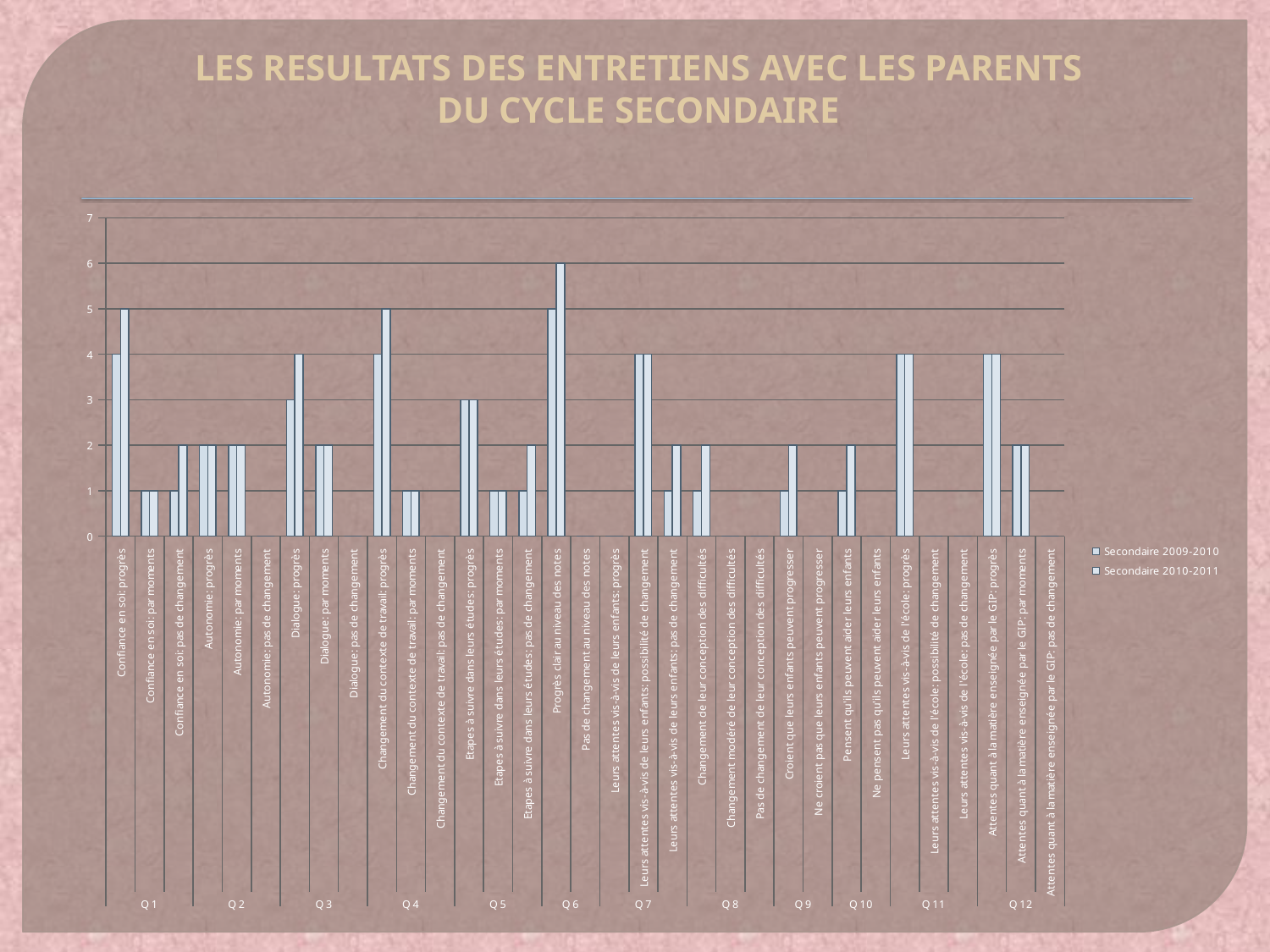
What is the value for 'Changement du contexte de travail: progrès' in the Secondaire 2010-2011 series? 5 What are the two series named in the legend? Secondaire 2009-2010 and Secondaire 2010-2011 What is the value for 'Progrès clair au niveau des notes' in the Secondaire 2010-2011 series? 6 What is the value for 'Dialogue: progrès' in the Secondaire 2009-2010 series? 3 Is the Secondaire 2010-2011 value for 'Progrès clair au niveau des notes' greater or less than 5? greater What kind of chart is shown on the slide? bar chart What is the value for 'Confiance en soi: progrès' in the Secondaire 2009-2010 series? 4 How many question groups (Q 1, Q 2, ...) are shown along the x axis? 12 Which category has the highest value in the Secondaire 2010-2011 series? Progrès clair au niveau des notes What is the difference between the Secondaire 2010-2011 and Secondaire 2009-2010 values for 'Progrès clair au niveau des notes'? 1 For 'Dialogue: progrès', which series has the larger value, Secondaire 2009-2010 or Secondaire 2010-2011? Secondaire 2010-2011 How many series does the legend list? 2